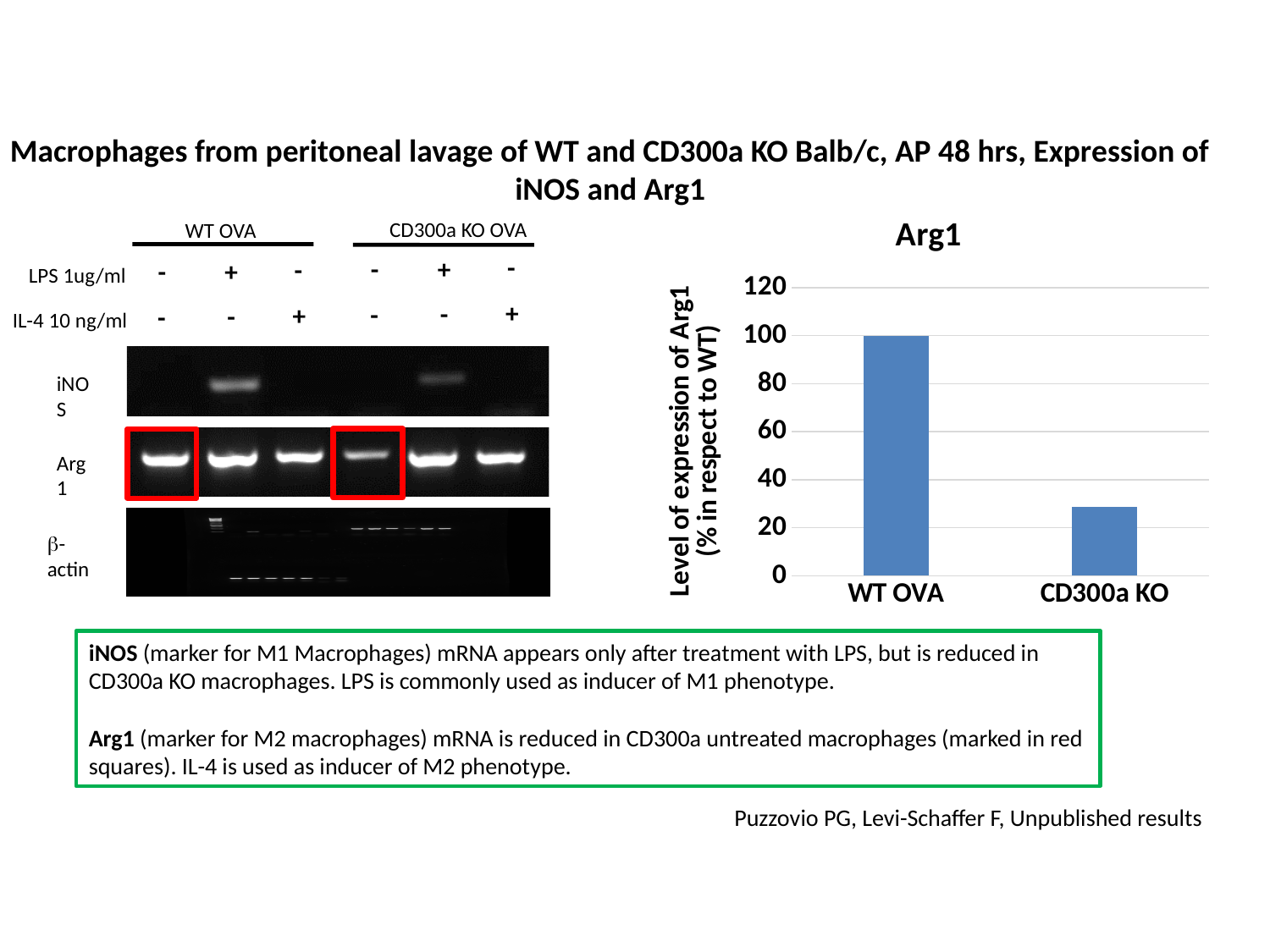
In the Arg1 chart, is the value for CD300a KO greater or less than 20? greater What is the title of the bar chart on the slide? Arg1 In the Arg1 chart, which is larger, the value for WT OVA or the value for CD300a KO? WT OVA In the Arg1 chart, is the value for CD300a KO greater or less than 40? less What is the label of the y axis in the Arg1 chart? Level of expression of Arg1 (% in respect to WT) Which category has the highest value in the Arg1 chart? WT OVA In the Arg1 chart, what is the level of expression for WT OVA? 100 What kind of chart is the Arg1 chart on the slide? bar chart How many categories are shown on the x axis of the Arg1 chart? 2 Do the values in the Arg1 chart rise or fall from WT OVA to CD300a KO? fall What is the highest value shown on the y axis of the Arg1 chart? 120 Which category has the lowest value in the Arg1 chart? CD300a KO